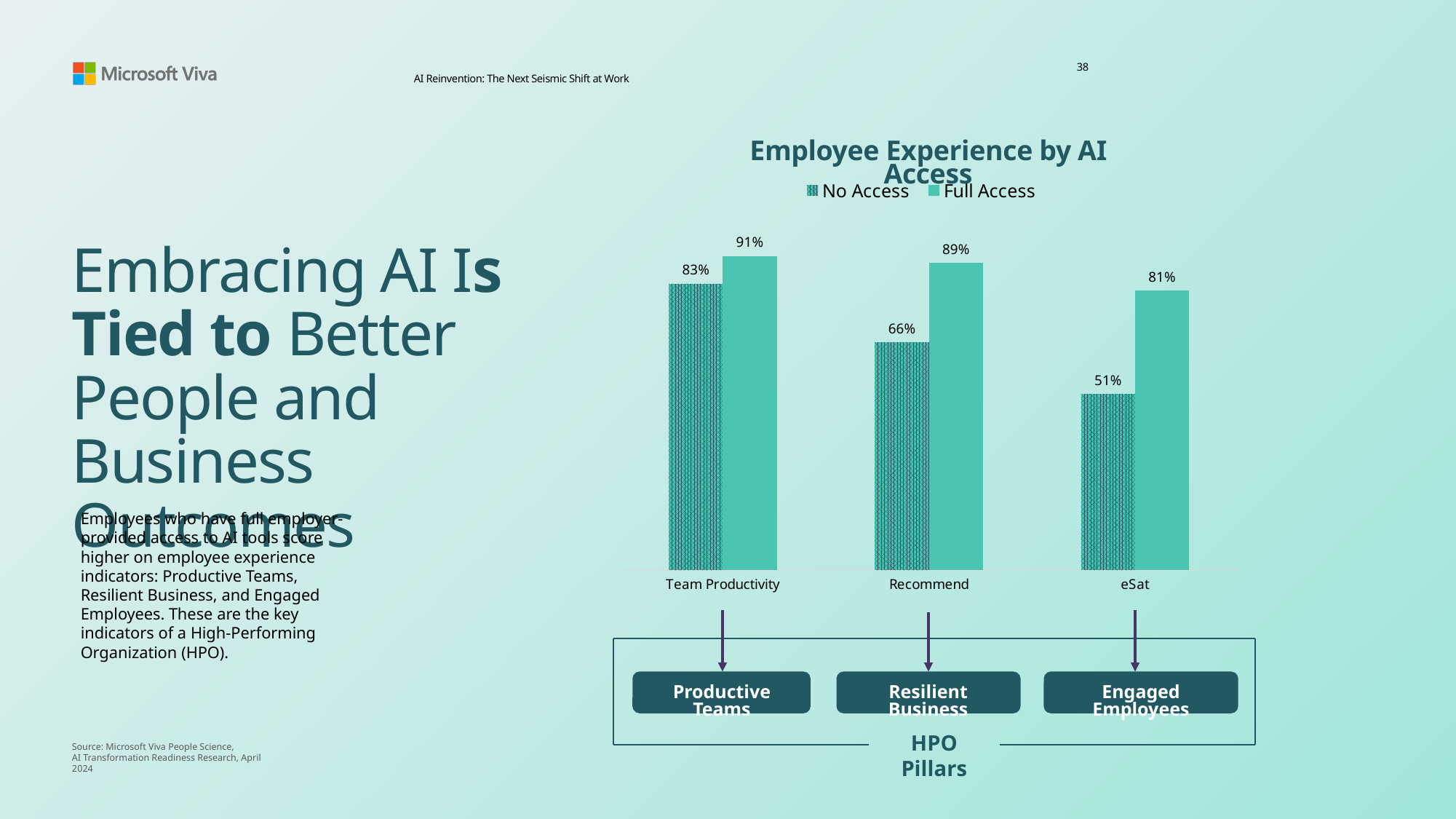
What is the title of the chart? Employee Experience by AI Access Which is larger for Team Productivity, the No Access value or the Full Access value? Full Access What kind of chart is shown on the slide? Bar chart What is the No Access value for eSat? 51% What is the Full Access value for Team Productivity? 91% Which category has the highest Full Access value? Team Productivity What is the difference between the Full Access and No Access values for eSat? 30% How many series does the chart legend list? 2 What is the No Access value for Recommend? 66% What is the difference between the Full Access and No Access values for Recommend? 23% Which category has the lowest No Access value? eSat How many categories are shown on the x axis of the chart? 3